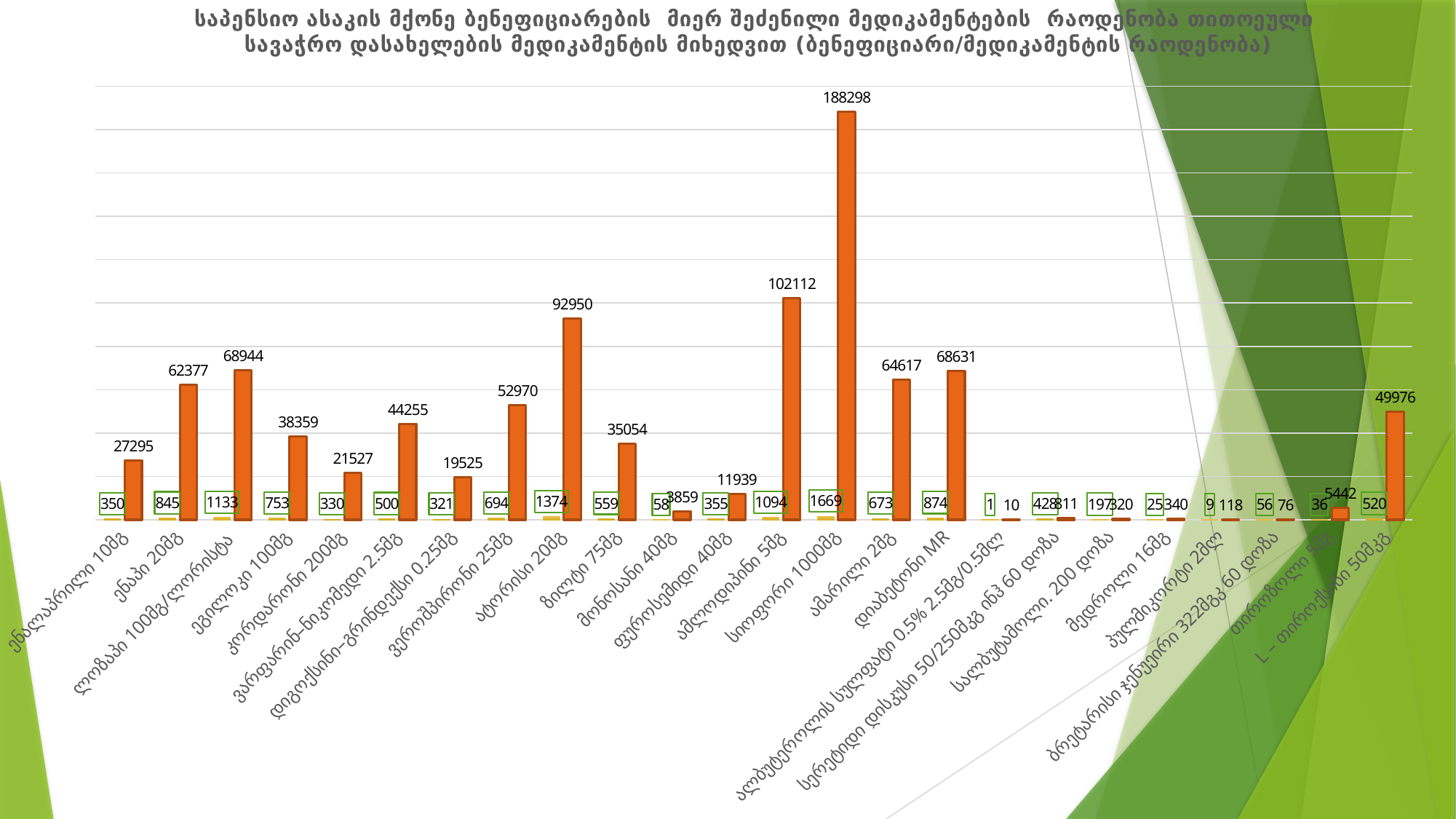
What is the value of the orange bar for L – თიროქსინი 50მკგ? 49976 What is the value of the orange bar for ენალაპრილი 10მგ? 27295 Which has a larger orange bar value, ენაპი 20მგ or ლოზაპი 100მგ/ლორისტა? ლოზაპი 100მგ/ლორისტა What is the value of the orange bar for ატორისი 20მგ? 92950 Which category has the highest orange bar? სიოფორი 1000მგ What is the value of the tall orange bar for სიოფორი 1000მგ? 188298 Which has a larger orange bar value, ვეროშპირონი 25მგ or ზილტი 75მგ? ვეროშპირონი 25მგ What is the difference between the orange bar values for სიოფორი 1000მგ and ამლოდიპინი 5მგ? 86186 What kind of chart is shown on the slide? bar chart Which category has the lowest orange bar value? ალბუტეროლის სულფატი 0.5% 2.5მგ/0.5მლ What is the value shown in the green box for ამლოდიპინი 5მგ? 1094 What is the difference between the orange bar values for დიაბეტონი MR and ამარილი 2მგ? 4014